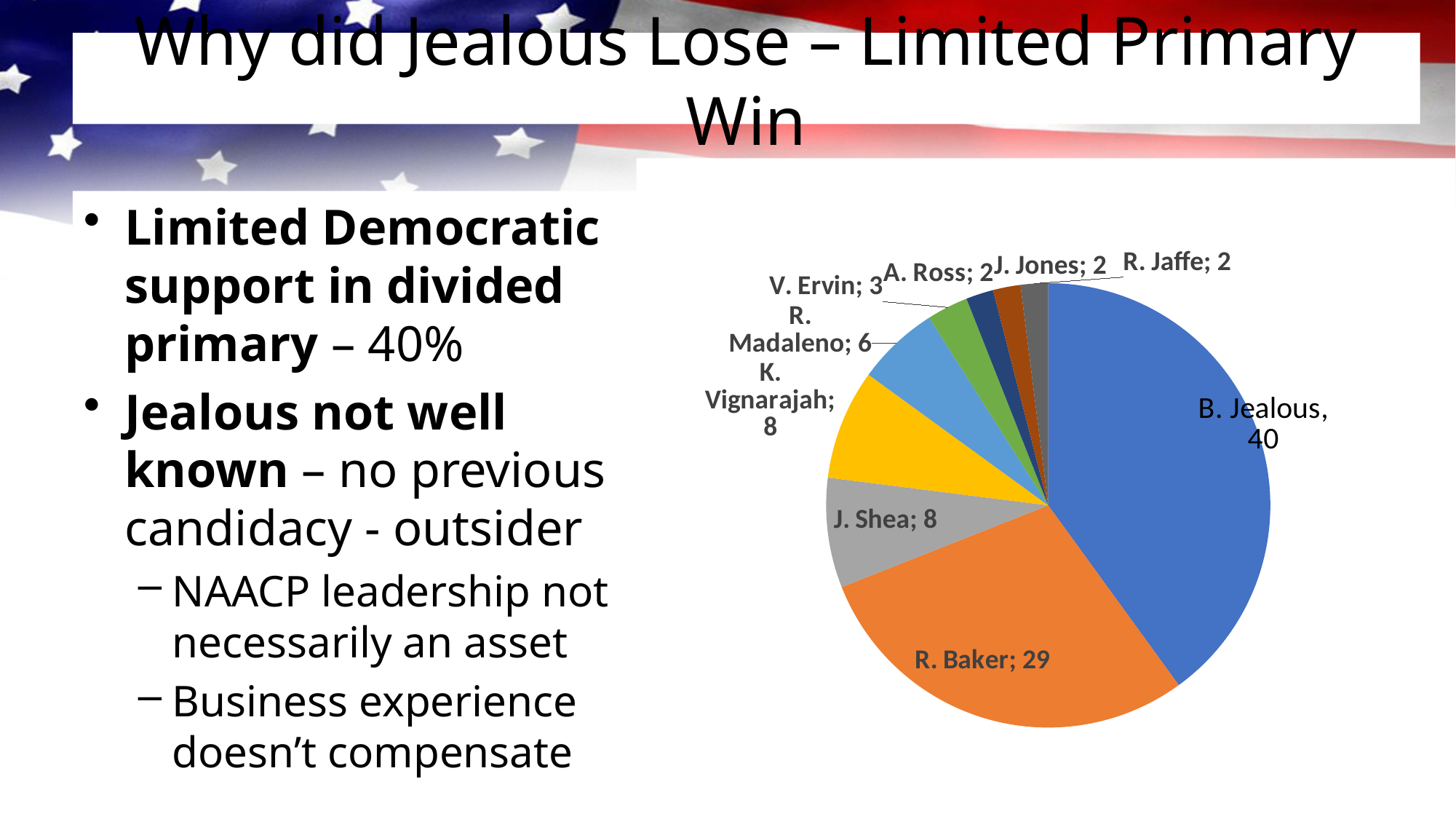
What value is shown for R. Baker in the pie chart? 29 Which candidate has the largest slice in the pie chart? B. Jealous What share of the pie does B. Jealous's slice represent? 40% What is the difference between the values for R. Baker and J. Shea? 21 What is the difference between the values for B. Jealous and R. Baker? 11 What value is shown for V. Ervin in the pie chart? 3 What value is shown for B. Jealous in the pie chart? 40 Which is larger, the value for R. Madaleno or the value for V. Ervin? R. Madaleno How many slices does the pie chart have? 9 What colour is the R. Baker slice in the pie chart? Orange What kind of chart is shown on the slide? Pie chart What value is shown for R. Madaleno in the pie chart? 6